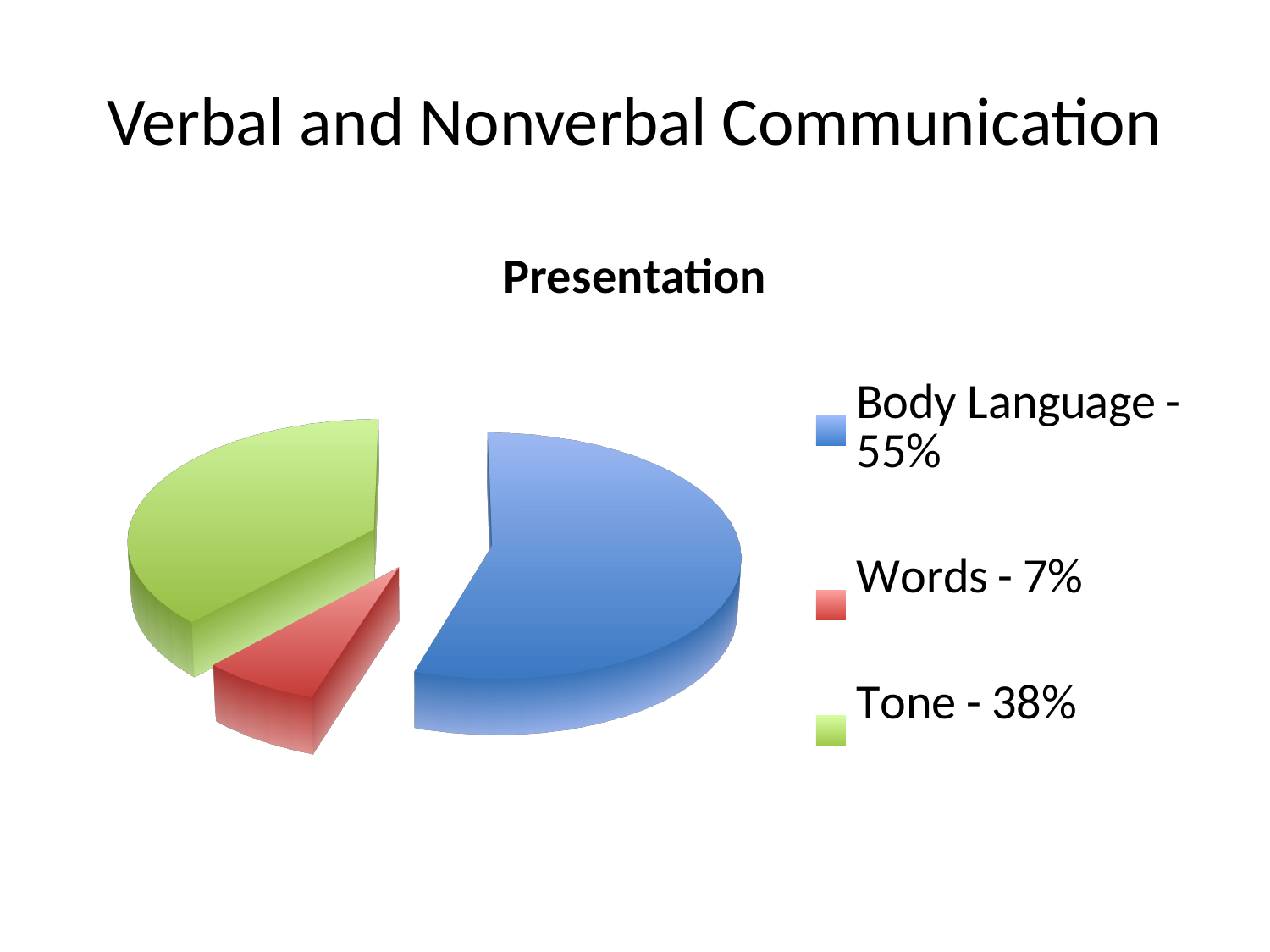
Which is larger, the share for Tone or the share for Words? Tone Which colour represents Tone in the pie chart? green What kind of chart is shown on the slide? pie chart What is the difference in percentage points between Body Language and Tone? 17 What is the title of the chart? Presentation What is the difference in percentage points between Tone and Words? 31 How many slices does the pie chart have? 3 What percentage does the legend give for Body Language? 55% What percentage does the legend give for Words? 7% What percentage does the legend give for Tone? 38% Which category has the largest slice of the pie? Body Language Which category has the smallest slice of the pie? Words